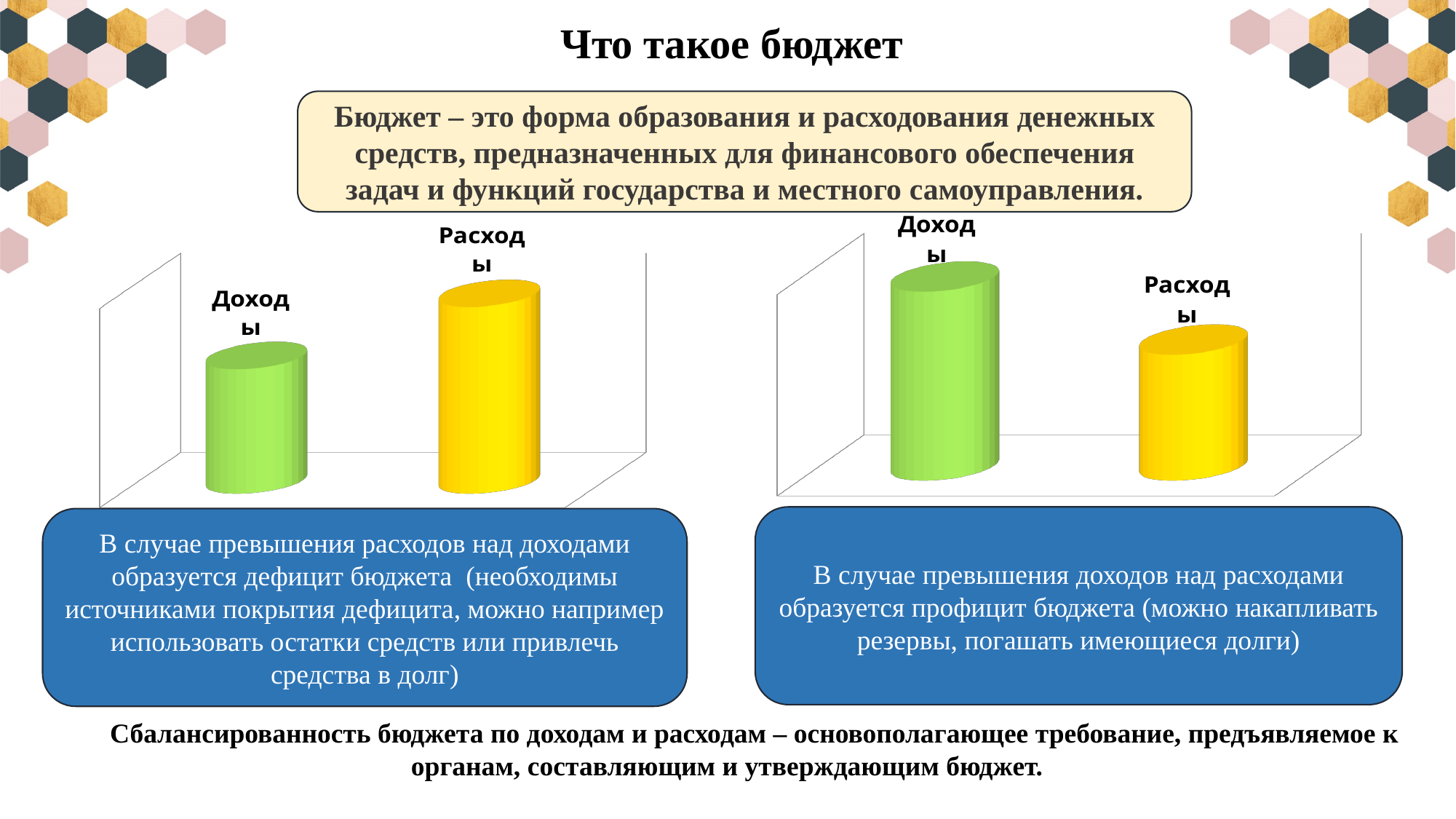
In the left chart, which is larger, Доходы or Расходы? Расходы In the right chart, which category has the lowest bar? Расходы In the right chart, which is larger, Доходы or Расходы? Доходы In the left chart, which category has the highest bar? Расходы What kind of chart is the left chart on the slide? bar chart How many categories does the right chart show? 2 In the right chart, what colour is the bar for Расходы? yellow How many categories does the left chart show? 2 In the left chart, what colour is the bar for Доходы? green In the left chart, which category has the lowest bar? Доходы What kind of chart is the right chart on the slide? bar chart In the right chart, which category has the highest bar? Доходы